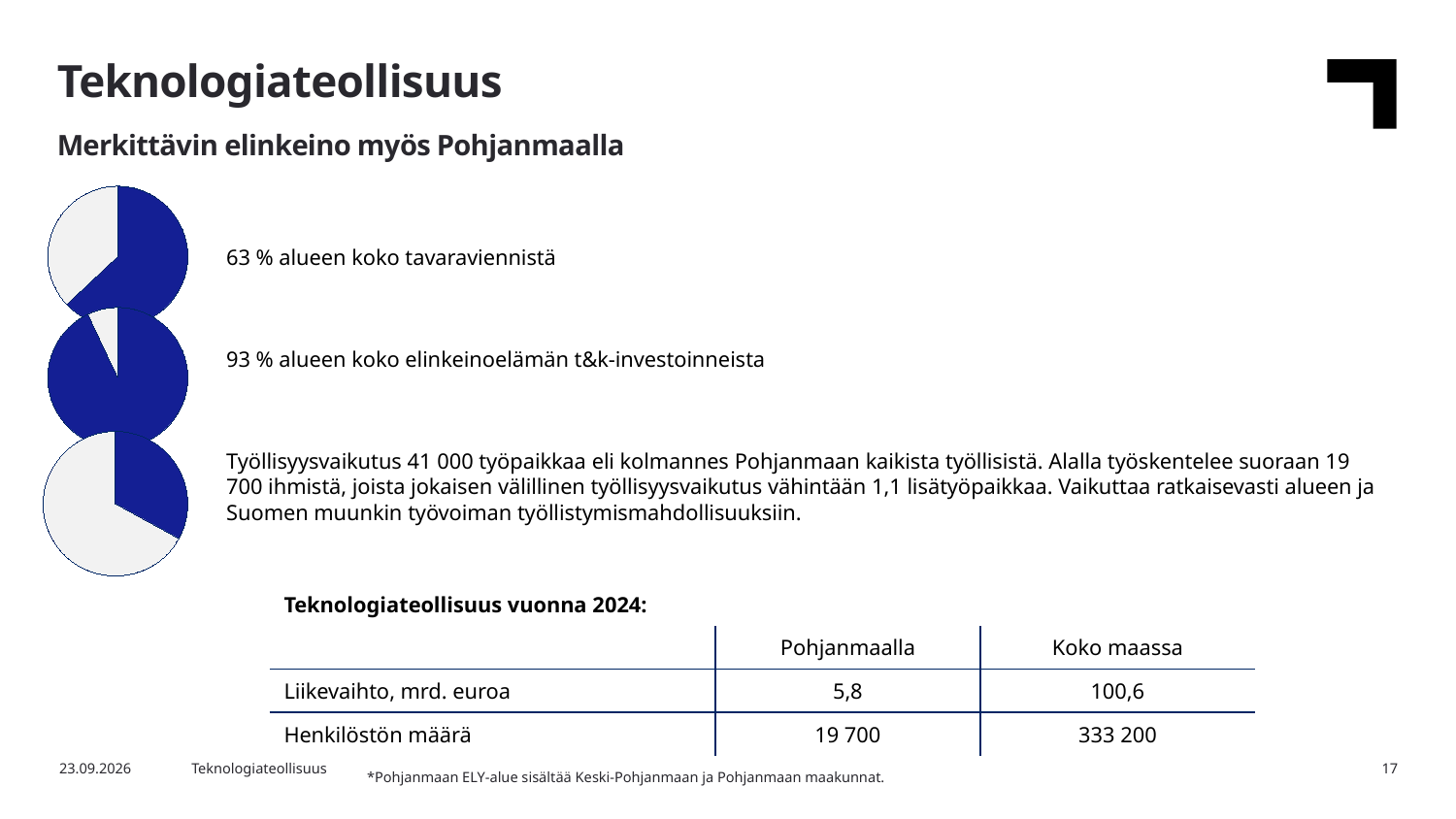
In the middle pie chart, what share of the region's business R&D investments does the blue slice represent, according to the text beside it? 93 % How many pie charts are on the slide? 3 How many slices does each pie chart have? 2 In the top pie chart, what share of the region's total goods exports does the blue slice represent, according to the text beside it? 63 % What kind of charts are shown on the left side of the slide? Pie charts In the top pie chart, is the blue slice greater or less than 50% of the pie? greater What colour is used for the highlighted slice in each pie chart? Blue What is the difference between the blue shares of the middle pie chart (93 %) and the top pie chart (63 %)? 30 percentage points Which of the three pie charts has the largest blue slice? The middle pie chart Is the blue slice larger in the top pie chart or in the bottom pie chart? The top pie chart In the bottom pie chart, is the blue slice greater or less than 50% of the pie? less Which of the three pie charts has the smallest blue slice? The bottom pie chart